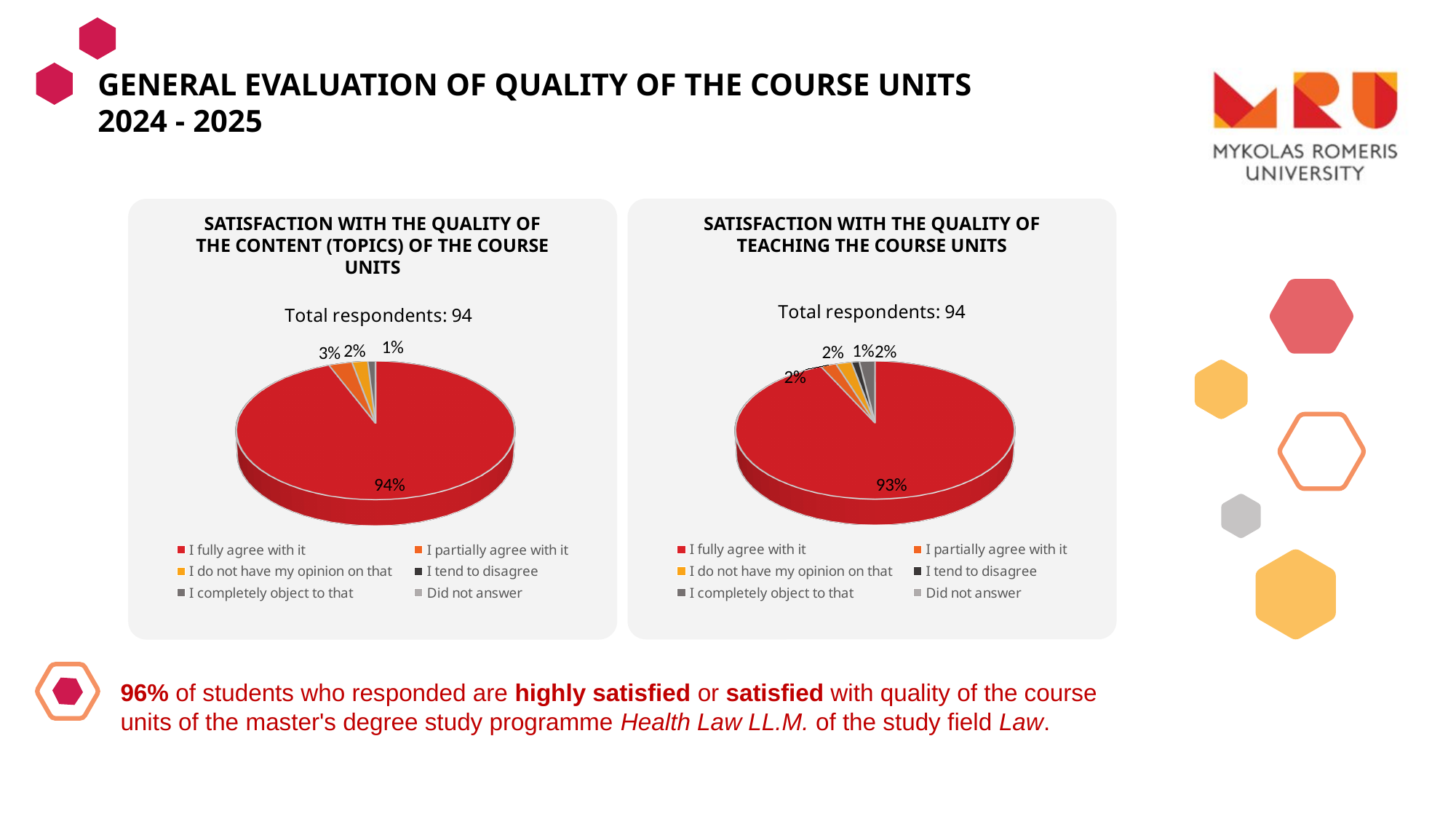
How many entries does the legend of the 'Satisfaction with the quality of teaching the course units' chart list? 6 In the 'Satisfaction with the quality of teaching the course units' chart, which category has the largest share? I fully agree with it How many total respondents are reported for the 'Satisfaction with the quality of the content (topics) of the course units' chart? 94 In the 'Satisfaction with the quality of the content (topics) of the course units' chart, what share of respondents fully agree with it? 94% In the 'Satisfaction with the quality of the content (topics) of the course units' chart, what share is labelled for the 'I partially agree with it' slice? 3% In the 'Satisfaction with the quality of the content (topics) of the course units' chart, which category has the largest share? I fully agree with it Which chart shows a larger share for 'I fully agree with it': the content (topics) chart or the teaching chart? The content (topics) chart In the 'Satisfaction with the quality of teaching the course units' chart, what share of respondents fully agree with it? 93% What is the difference between the 'I fully agree with it' share in the content (topics) chart and in the teaching chart? 1% What colour is the 'I fully agree with it' slice in the 'Satisfaction with the quality of teaching the course units' chart? Red Is the 'I fully agree with it' share in the 'Satisfaction with the quality of teaching the course units' chart greater or less than 50%? greater What type of chart is used in the 'Satisfaction with the quality of the content (topics) of the course units' chart? Pie chart